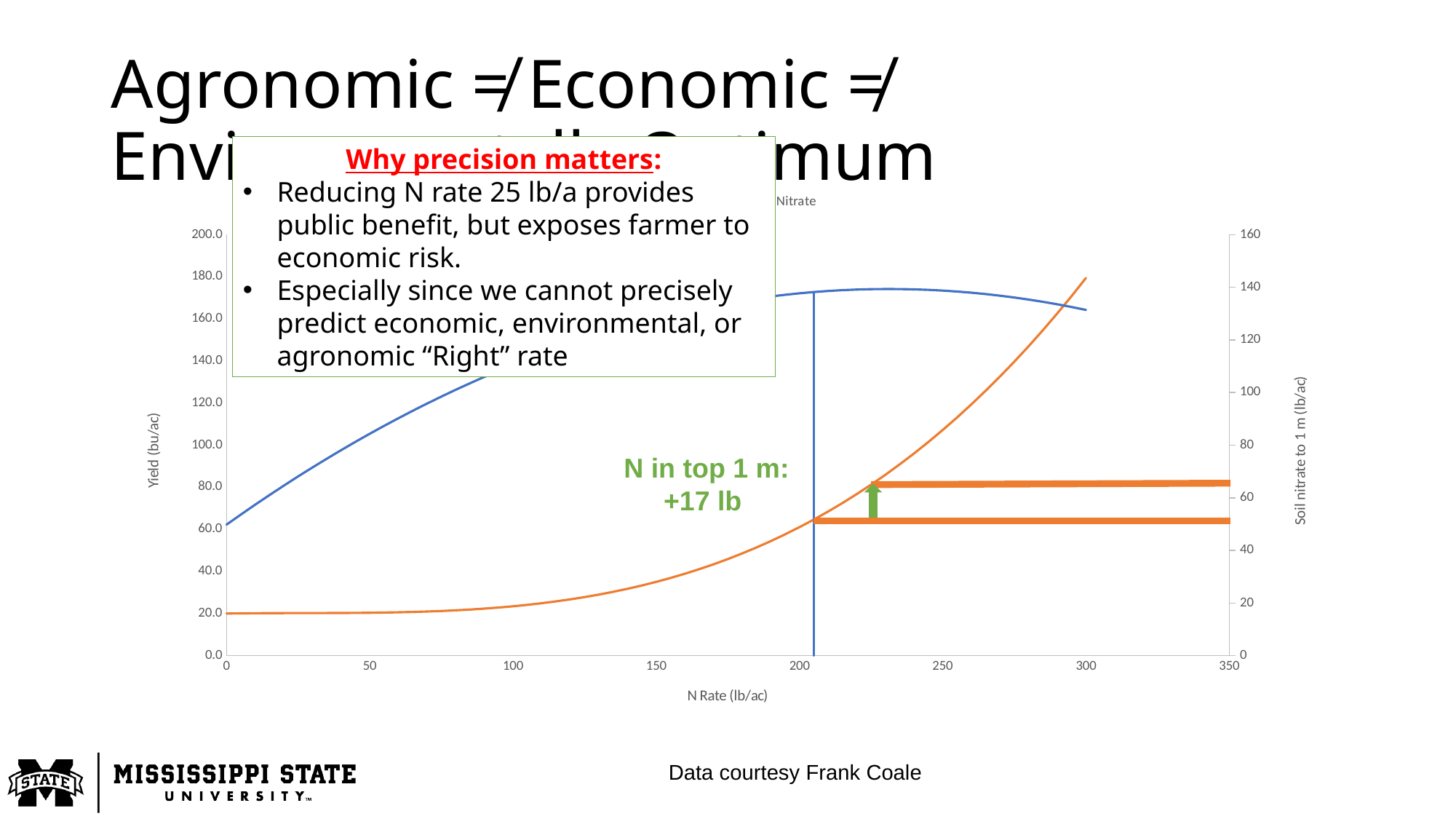
What is the label of the x axis of the chart? N Rate (lb/ac) Is the value of the orange soil nitrate line at an N rate of 300 greater or less than 120 on the right axis? greater What kind of chart is shown on the slide? line chart Is the value of the blue yield line at an N rate of 300 greater or less than 140 on the left axis? greater Is the value of the blue yield line at an N rate of 0 greater or less than 40 on the left axis? greater What is the highest value shown on the right y axis of the chart? 160 According to the green annotation on the chart, by how much does N in the top 1 m increase? +17 lb What is the label of the left y axis of the chart? Yield (bu/ac) What is the highest value shown on the left y axis of the chart? 200.0 Does the orange soil nitrate line rise or fall as N rate increases along the x axis? rise What is the highest N rate value shown on the x axis of the chart? 350